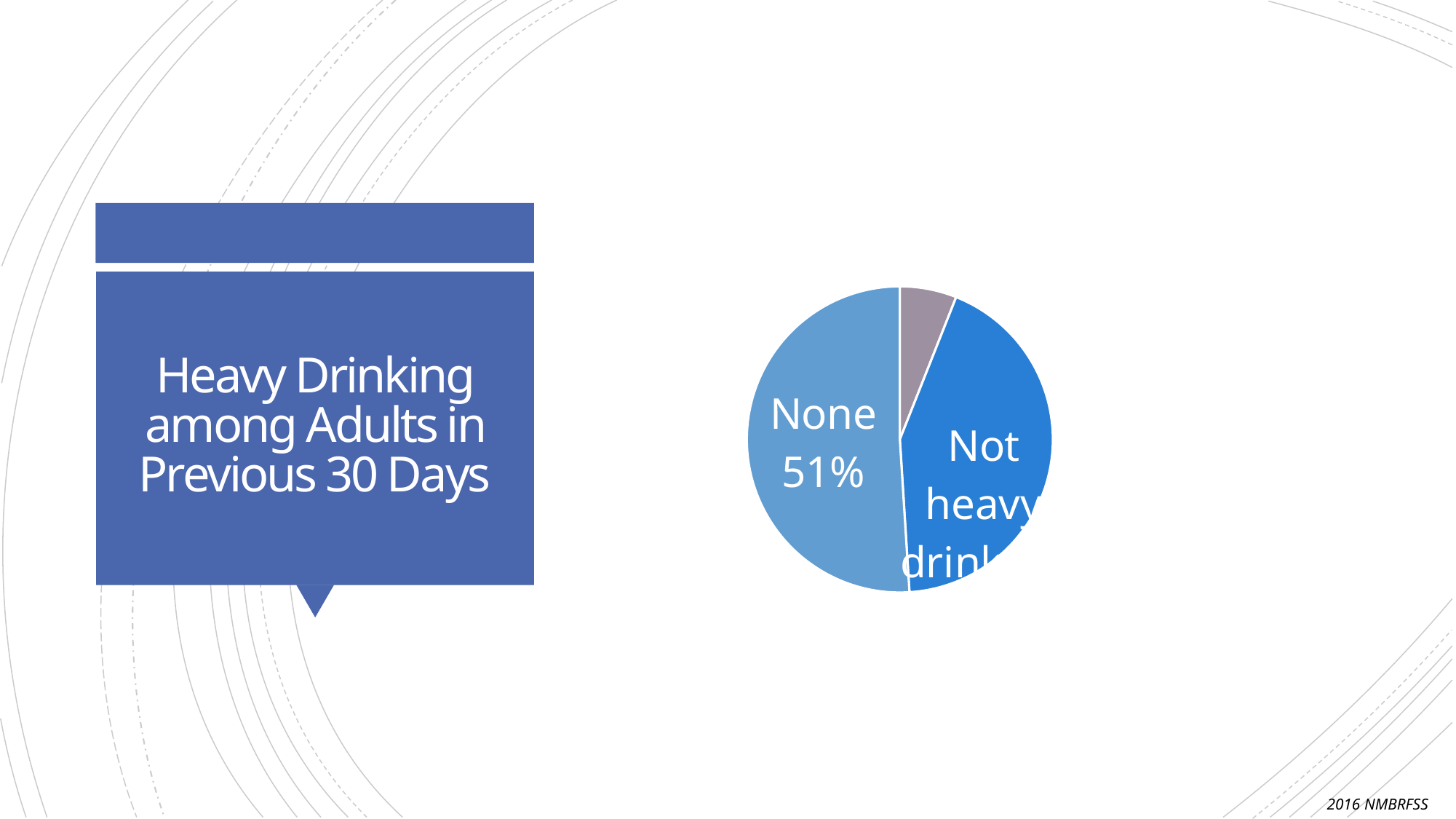
What colour is the smallest slice of the pie chart? grey How many slices does the pie chart have? 3 Is the share for "None" greater or less than 50%? greater What percentage of the pie is labelled "None"? 51% What kind of chart is shown on the slide? pie chart What share of the pie does the "None" slice represent? 51% What is the title shown in the text box next to the pie chart? Heavy Drinking among Adults in Previous 30 Days Which slice is larger, "None" or "Not heavy drinking"? None Which slice of the pie chart is the largest? None